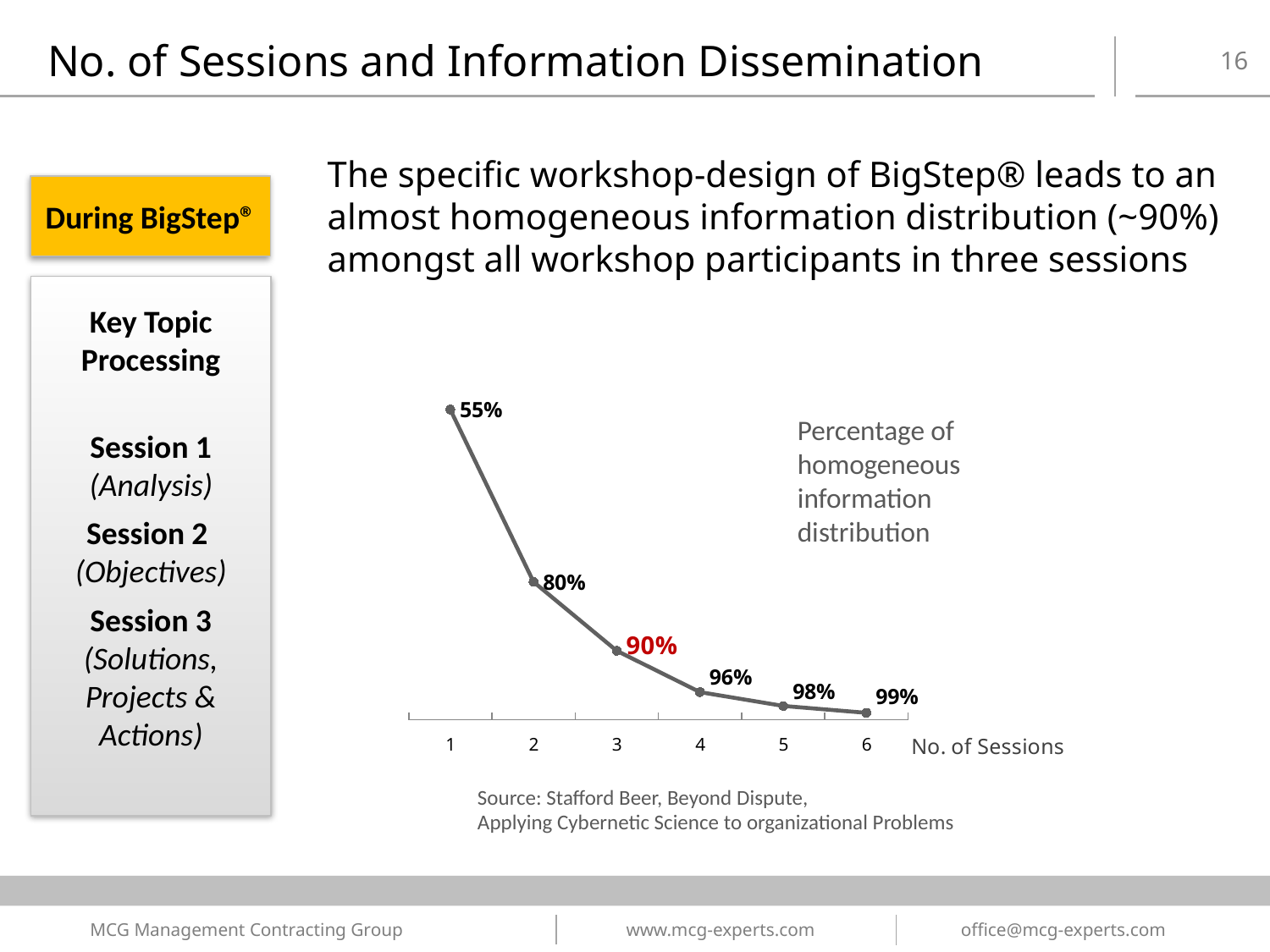
What is the percentage of homogeneous information distribution after 1 session? 55% What kind of chart is shown on the slide? Line chart What is the difference in percentage points between the value at 2 sessions and the value at 1 session? 25 What is the percentage of homogeneous information distribution after 6 sessions? 99% Which number of sessions has the lowest percentage of homogeneous information distribution? 1 Do the labelled percentage values rise or fall as the number of sessions increases? Rise What is the percentage of homogeneous information distribution after 4 sessions? 96% How many data points are plotted on the chart? 6 What is the difference in percentage points between the value at 3 sessions and the value at 2 sessions? 10 What is the percentage of homogeneous information distribution after 3 sessions? 90% Which number of sessions has the highest percentage of homogeneous information distribution? 6 Which is larger, the value at 5 sessions or the value at 4 sessions? 5 sessions